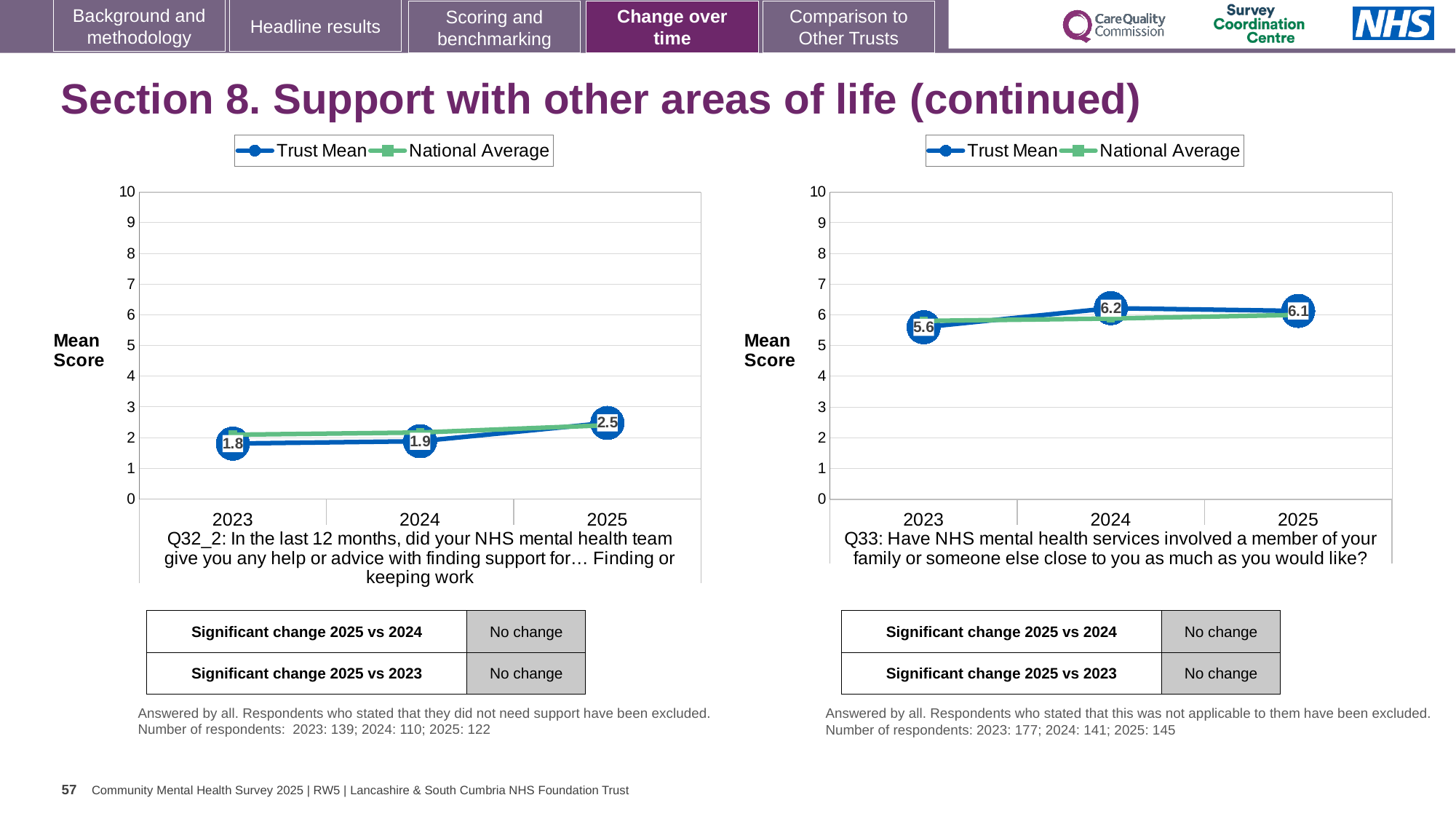
In the left chart (Q32_2), what is the Trust Mean for 2023? 1.8 In the right chart (Q33), what is the difference between the Trust Mean for 2024 and 2023? 0.6 What kind of chart is the right chart (Q33)? Line chart In the right chart (Q33), what is the Trust Mean for 2023? 5.6 In the right chart (Q33), which year has the highest Trust Mean? 2024 In the left chart (Q32_2), does the Trust Mean rise or fall from 2023 to 2025? Rise In the right chart (Q33), is the Trust Mean for 2023 greater or less than 6? less In the left chart (Q32_2), what is the difference between the Trust Mean for 2025 and 2024? 0.6 In the left chart (Q32_2), what is the Trust Mean for 2025? 2.5 How many series does the legend of the left chart (Q32_2) list? 2 In the left chart (Q32_2), which year has the lowest Trust Mean? 2023 In the right chart (Q33), what is the Trust Mean for 2024? 6.2